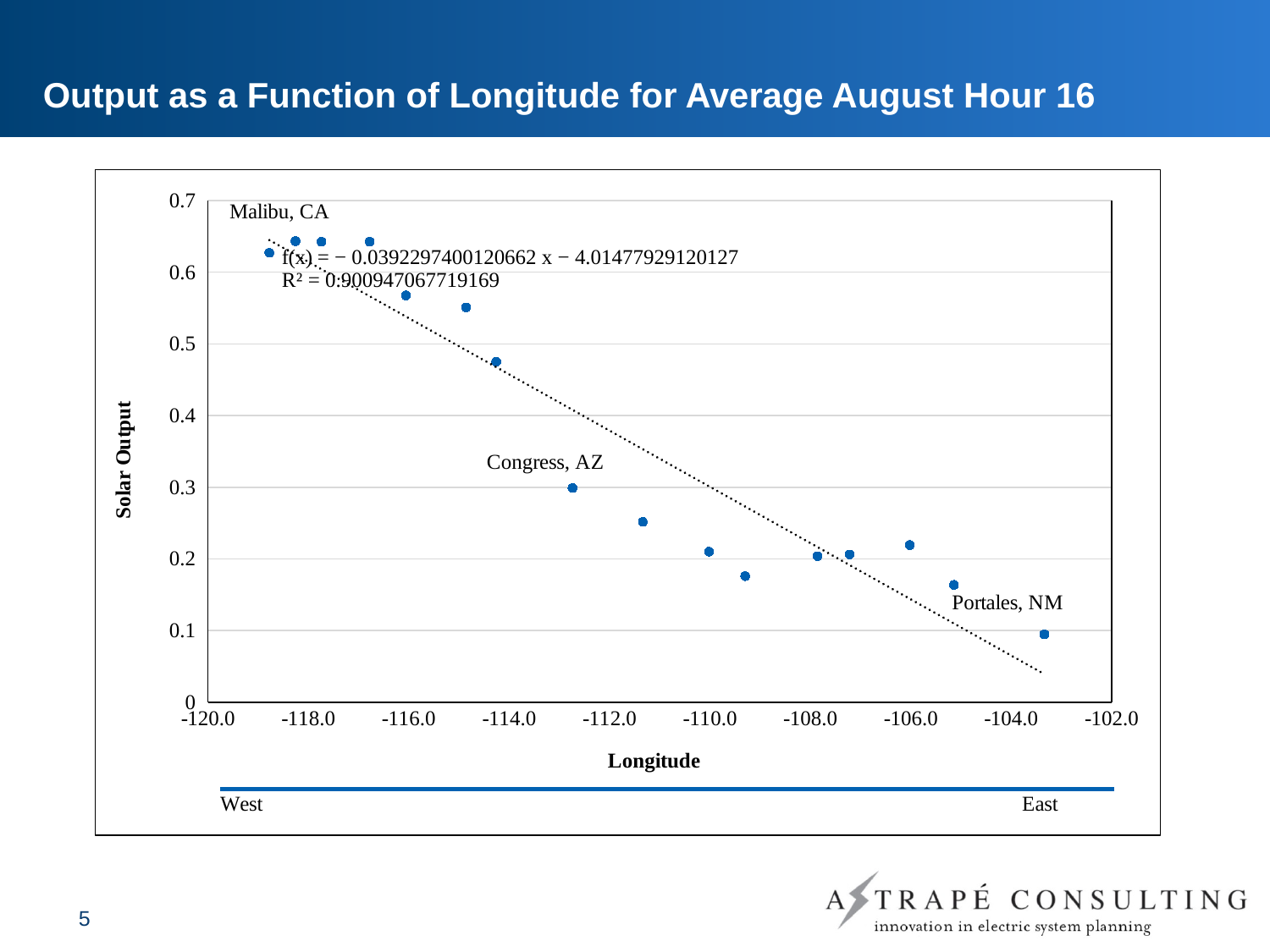
Is the solar output for Portales, NM greater or less than 0.2? less Is the solar output for Congress, AZ greater or less than 0.4? less What is the label of the vertical axis? Solar Output Is the solar output for Malibu, CA greater or less than 0.5? greater What type of chart is shown on the slide? Scatter chart Which labeled location has the highest solar output? Malibu, CA Which has a higher solar output, Congress, AZ or Portales, NM? Congress, AZ Which labeled location has the lowest solar output? Portales, NM What R² value is shown for the trendline? 0.900947067719169 Does solar output rise or fall as longitude increases from west to east? fall What is the title of the chart? Output as a Function of Longitude for Average August Hour 16 How many data points are plotted on the chart? 16